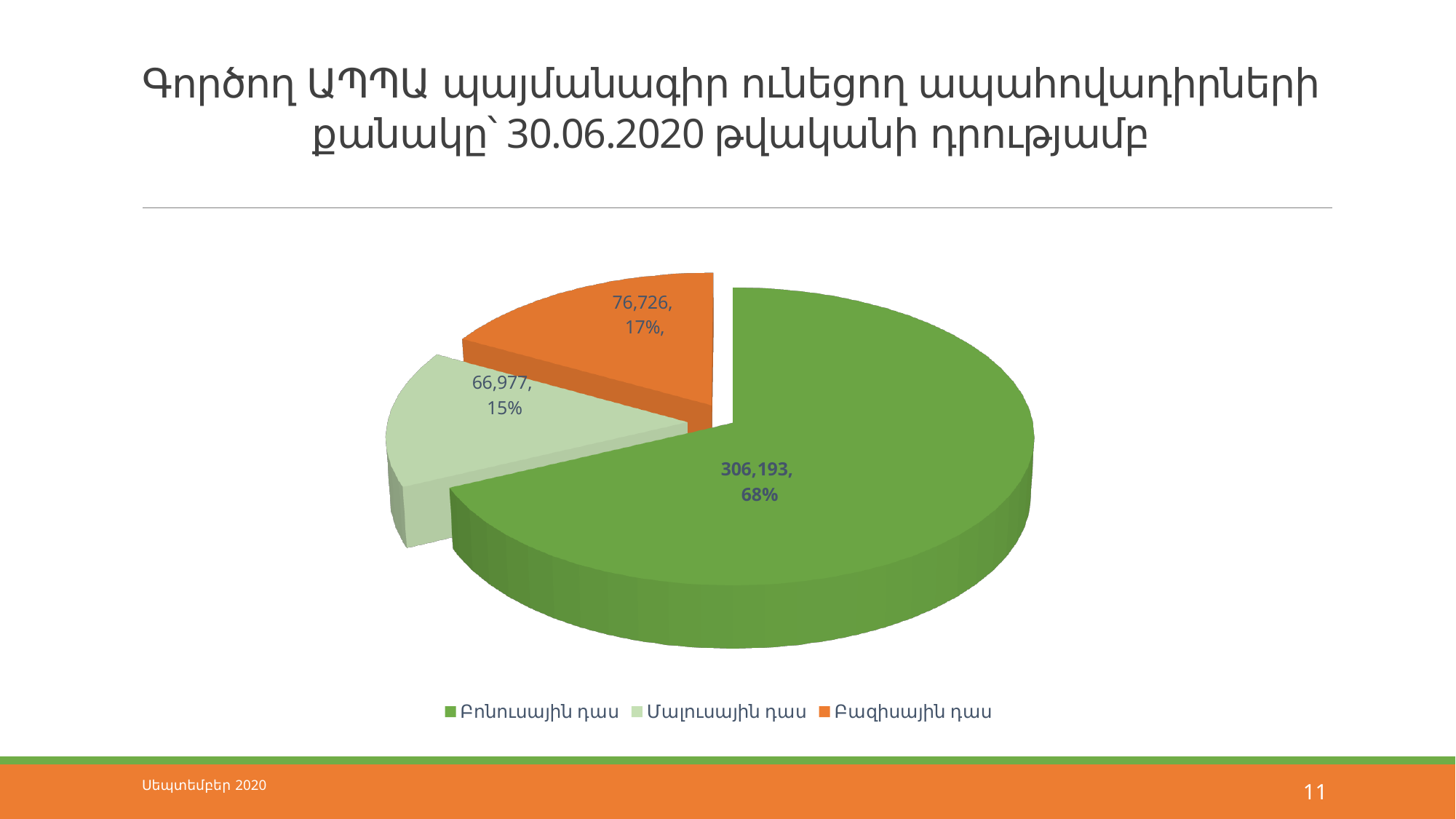
How many entries does the legend list? 3 What kind of chart is shown on the slide? Pie chart What share of the pie does Բազիսային դաս represent? 17% What is the value shown for Բազիսային դաս? 76,726 What is the difference between the values for Բազիսային դաս and Մալուսային դաս? 9,749 What is the value shown for Բոնուսային դաս? 306,193 How many slices does the pie chart have? 3 What is the value shown for Մալուսային դաս? 66,977 Which category has the smallest slice? Մալուսային դաս What share of the pie does Բոնուսային դաս represent? 68% Which category has the largest slice? Բոնուսային դաս Which colour represents Բազիսային դաս in the chart? Orange